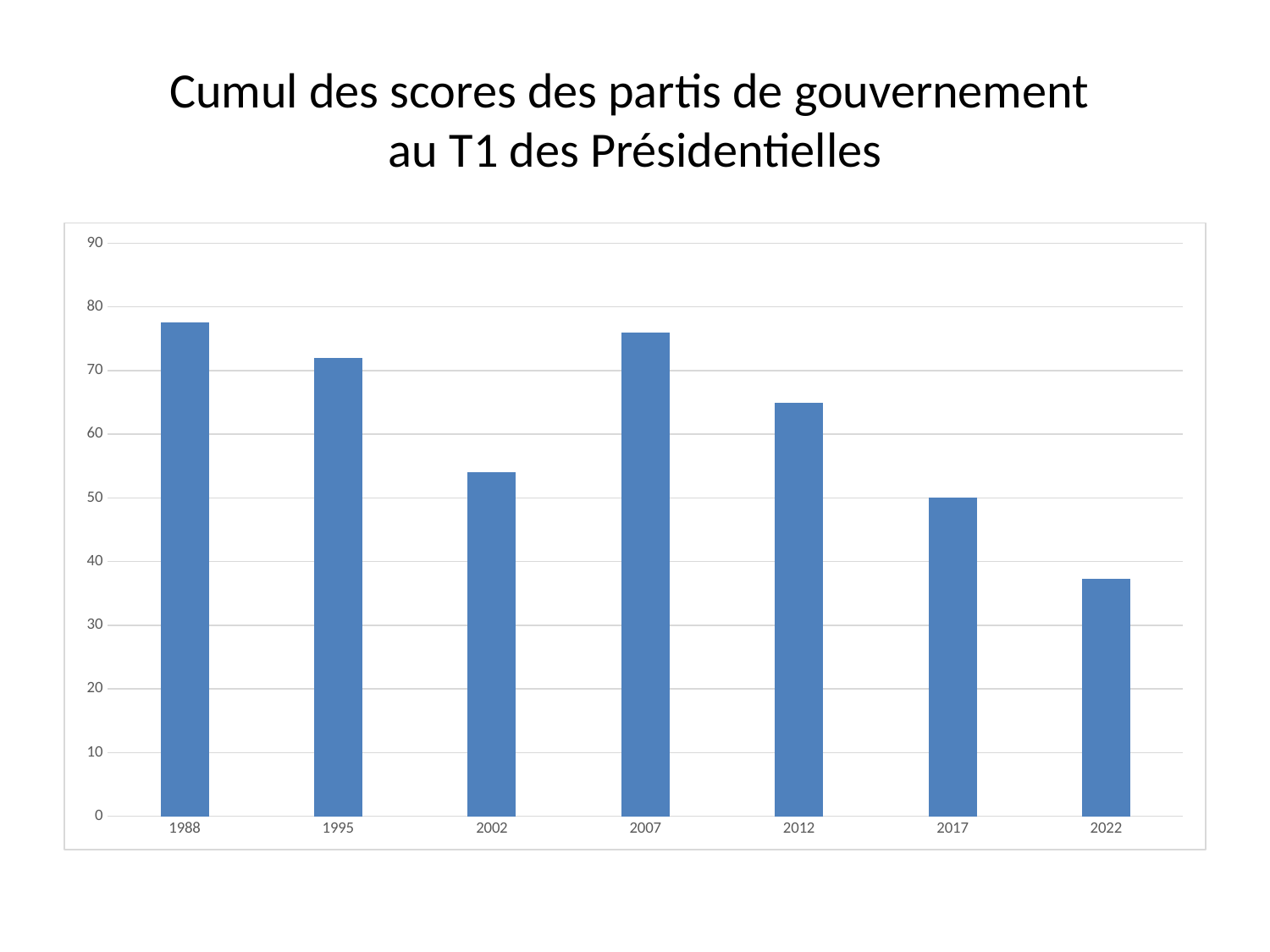
Which is larger, the value for 1995 or the value for 2012? 1995 Which is larger, the value for 2002 or the value for 2007? 2007 Is the value for 2007 greater or less than 80? less Is the value for 2012 greater or less than 60? greater What is the title of the chart on the slide? Cumul des scores des partis de gouvernement au T1 des Présidentielles Is the value for 2022 greater or less than 40? less Overall, do the values rise or fall from 1988 to 2022? fall Which year has the lowest value in the chart? 2022 What kind of chart is shown on the slide? bar chart How many years are shown on the x axis of the chart? 7